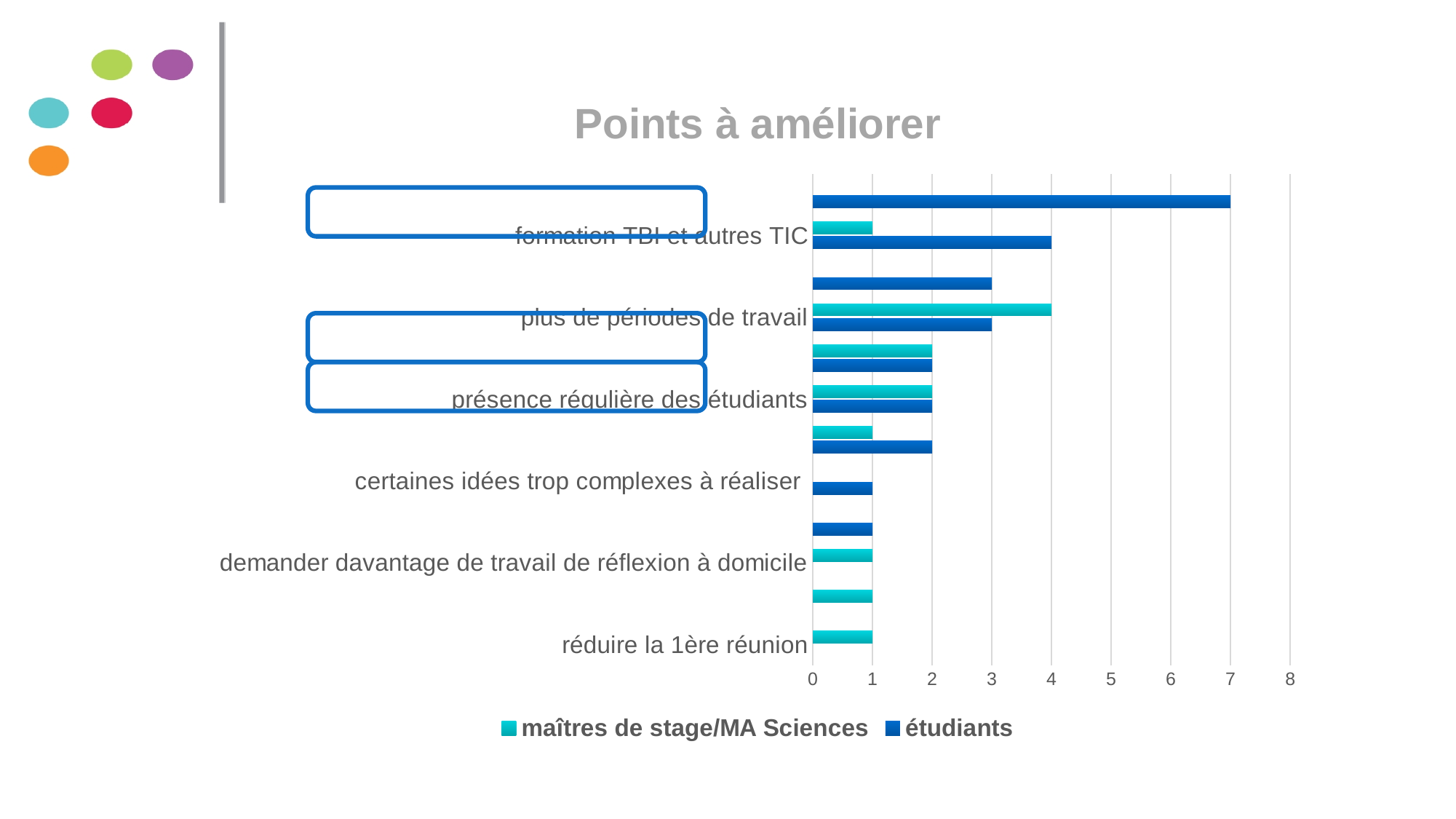
What kind of chart is shown on the slide? bar chart What is the value for maîtres de stage/MA Sciences for 'formation TBI et autres TIC'? 1 What is the value for maîtres de stage/MA Sciences for 'plus de périodes de travail'? 4 What is the highest value reached by any étudiants bar? 7 What is the value for maîtres de stage/MA Sciences for 'réduire la 1ère réunion'? 1 For 'formation TBI et autres TIC', which series has the larger value, maîtres de stage/MA Sciences or étudiants? étudiants What is the value for étudiants for 'plus de périodes de travail'? 3 What is the value for étudiants for 'présence régulière des étudiants'? 2 Which two series are listed in the legend? maîtres de stage/MA Sciences and étudiants How many series does the legend list? 2 What is the value for étudiants for 'formation TBI et autres TIC'? 4 What is the title of the chart? Points à améliorer